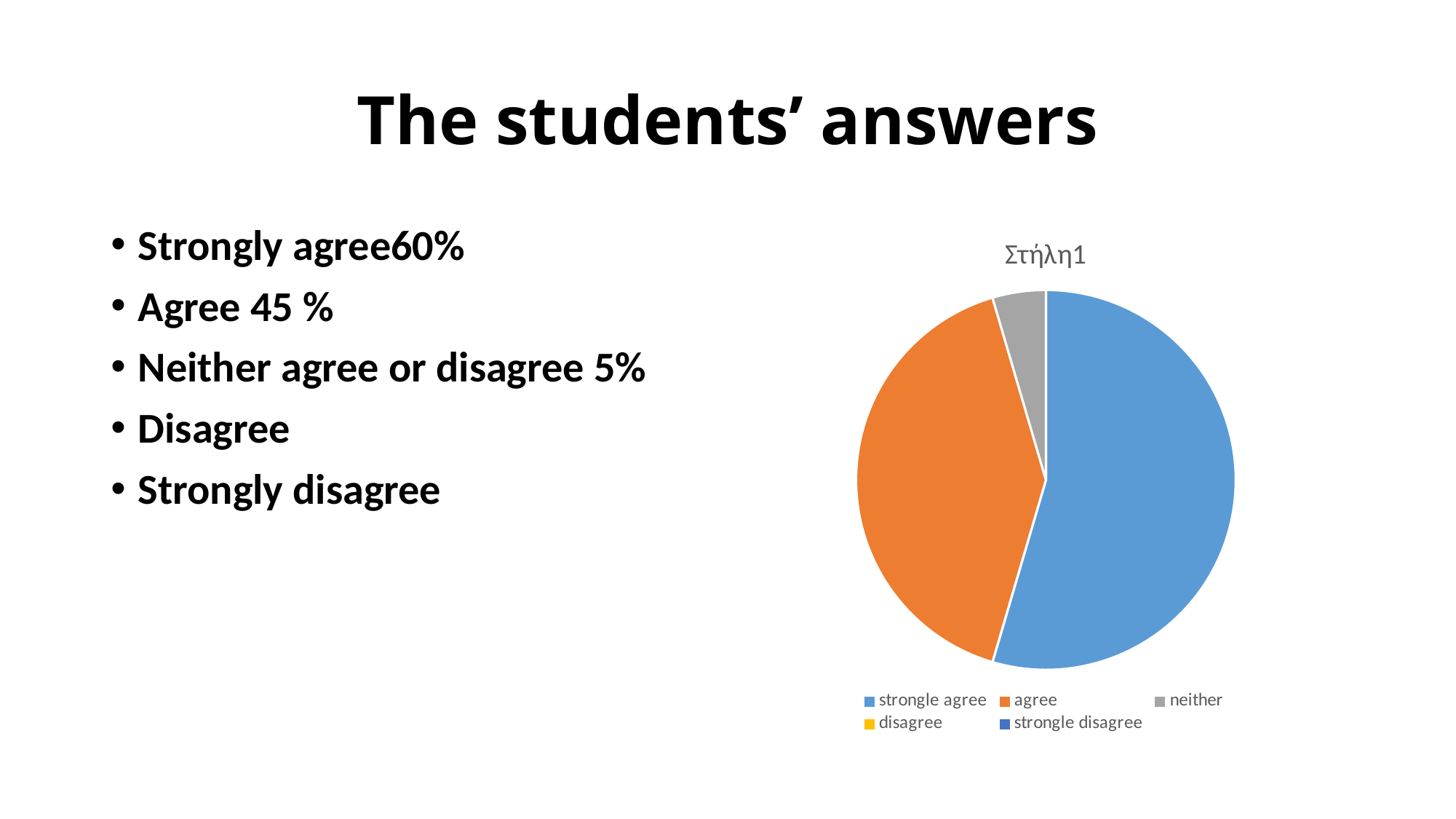
How many entries does the pie chart's legend list? 5 In the pie chart, which slice is larger: strongle agree or agree? strongle agree What colour is the slice for agree in the pie chart? orange Which of the visible slices in the pie chart is the smallest? neither What kind of chart is shown on the slide? pie chart What is the title of the pie chart? Στήλη1 How many slices are visible in the pie chart? 3 Which category has the largest slice of the pie chart? strongle agree In the pie chart, which slice is larger: agree or neither? agree